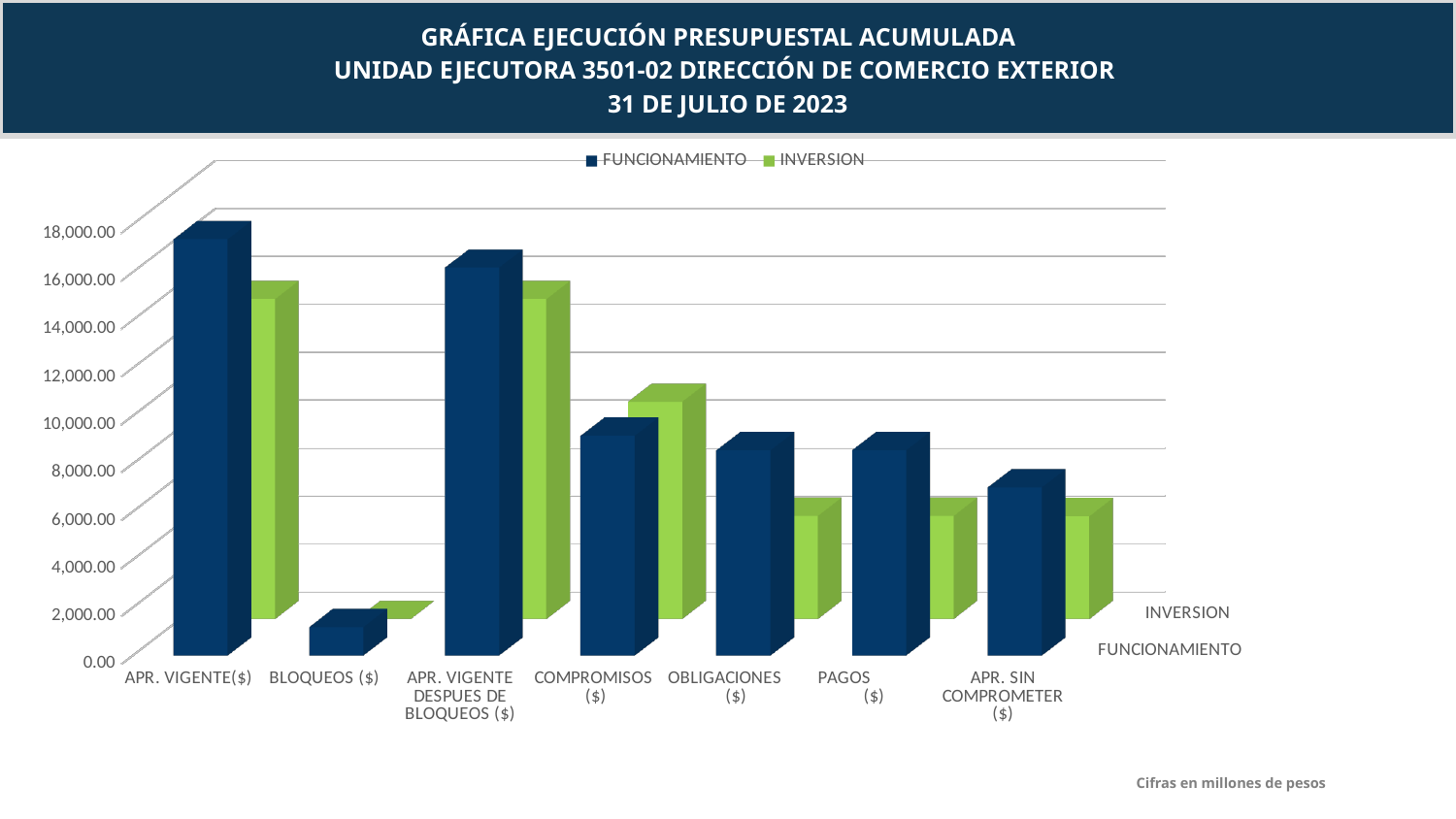
Which category has the lowest INVERSION value? BLOQUEOS ($) What kind of chart is shown on the slide? bar chart How many series does the legend list? 2 Which category has the highest FUNCIONAMIENTO value? APR. VIGENTE($) How many categories are shown on the x axis? 7 Which category has the lowest FUNCIONAMIENTO value? BLOQUEOS ($) For OBLIGACIONES ($), which series has the larger value, FUNCIONAMIENTO or INVERSION? FUNCIONAMIENTO According to the note on the slide, in what units are the figures expressed? millones de pesos Is the FUNCIONAMIENTO value for BLOQUEOS ($) greater or less than 4,000.00? less Is the FUNCIONAMIENTO value for PAGOS ($) greater or less than 6,000.00? greater Is the FUNCIONAMIENTO value for APR. VIGENTE($) greater or less than 14,000.00? greater